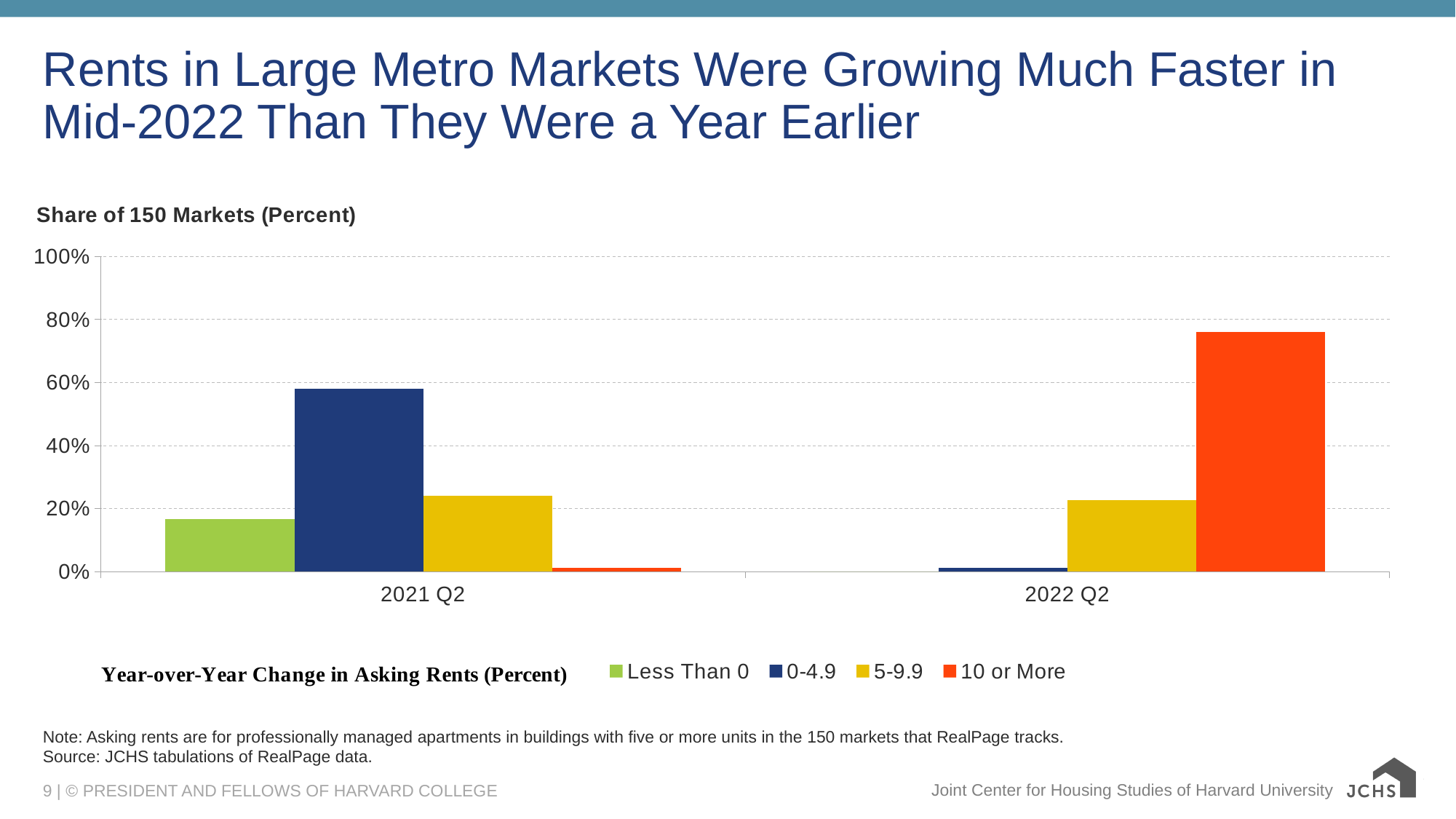
In 2022 Q2, which rent-change category has the highest share of markets? 10 or More Is the share for the 10 or More category in 2022 Q2 greater or less than 60%? greater What kind of chart is shown on the slide? Bar chart Is the share for the 0-4.9 category in 2021 Q2 greater or less than 40%? greater Is the share for the 5-9.9 category in 2021 Q2 greater or less than 40%? less Which period has the larger share of markets in the 10 or More category, 2021 Q2 or 2022 Q2? 2022 Q2 In 2021 Q2, which rent-change category has the highest share of markets? 0-4.9 In 2021 Q2, which rent-change category has the lowest share of markets? 10 or More What is the label on the vertical axis of the chart? Share of 150 Markets (Percent) How many time periods are shown on the x axis? 2 What does the legend title say the series represent? Year-over-Year Change in Asking Rents (Percent) How many series does the legend list? 4